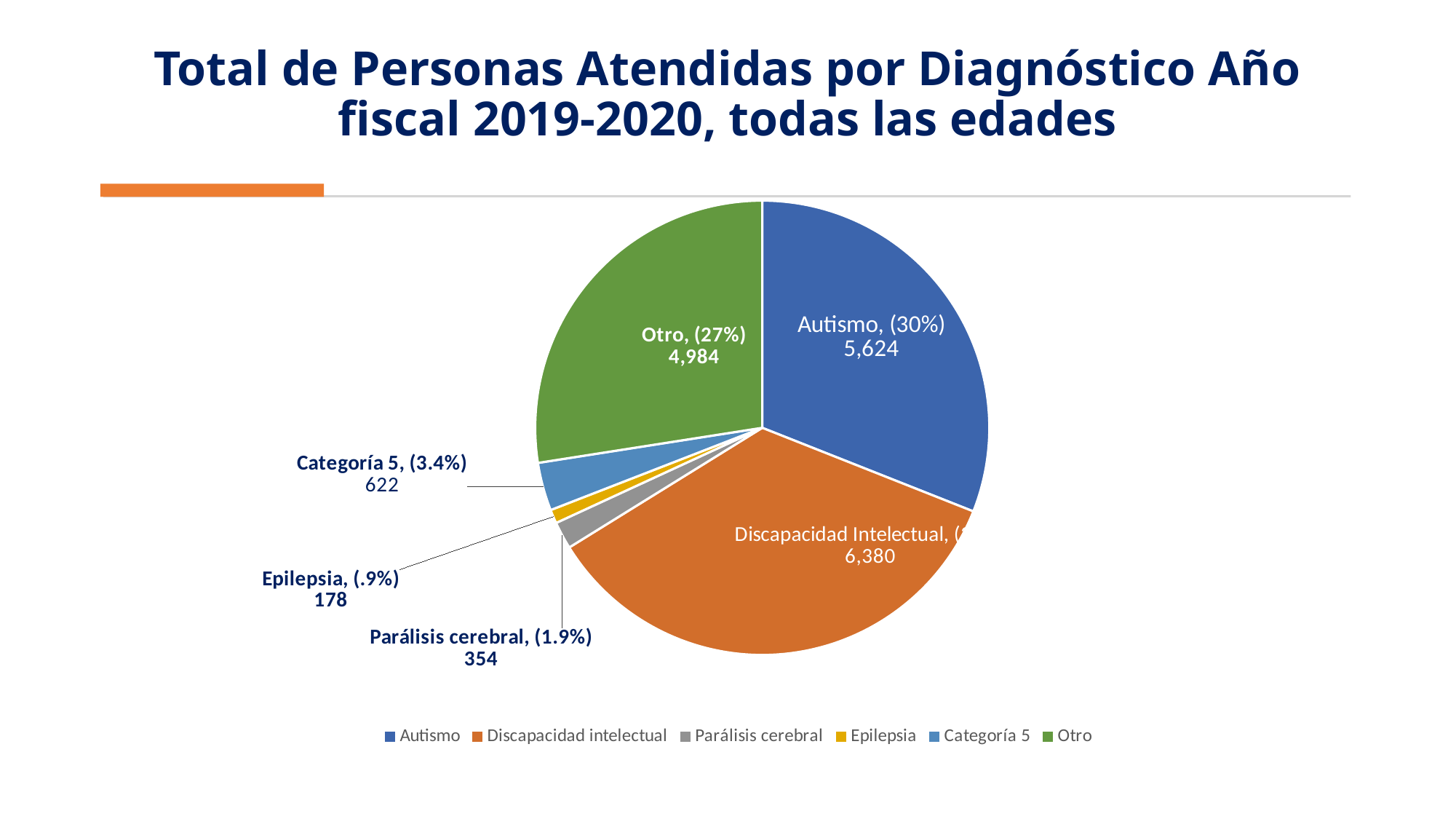
Which diagnosis category has the smallest slice of the pie? Epilepsia What is the value shown for Epilepsia? 178 What is the value shown for Discapacidad Intelectual? 6,380 What is the value shown for Otro? 4,984 What type of chart is shown on the slide? Pie chart What share of the pie does Autismo represent? 30% What is the difference between the values for Discapacidad Intelectual and Autismo? 756 How many people were attended with a diagnosis of Autismo? 5,624 Which is larger, the value for Categoría 5 or the value for Parálisis cerebral? Categoría 5 What share of the pie does Categoría 5 represent? 3.4% How many categories does the legend list? 6 Which diagnosis category has the largest slice of the pie? Discapacidad Intelectual